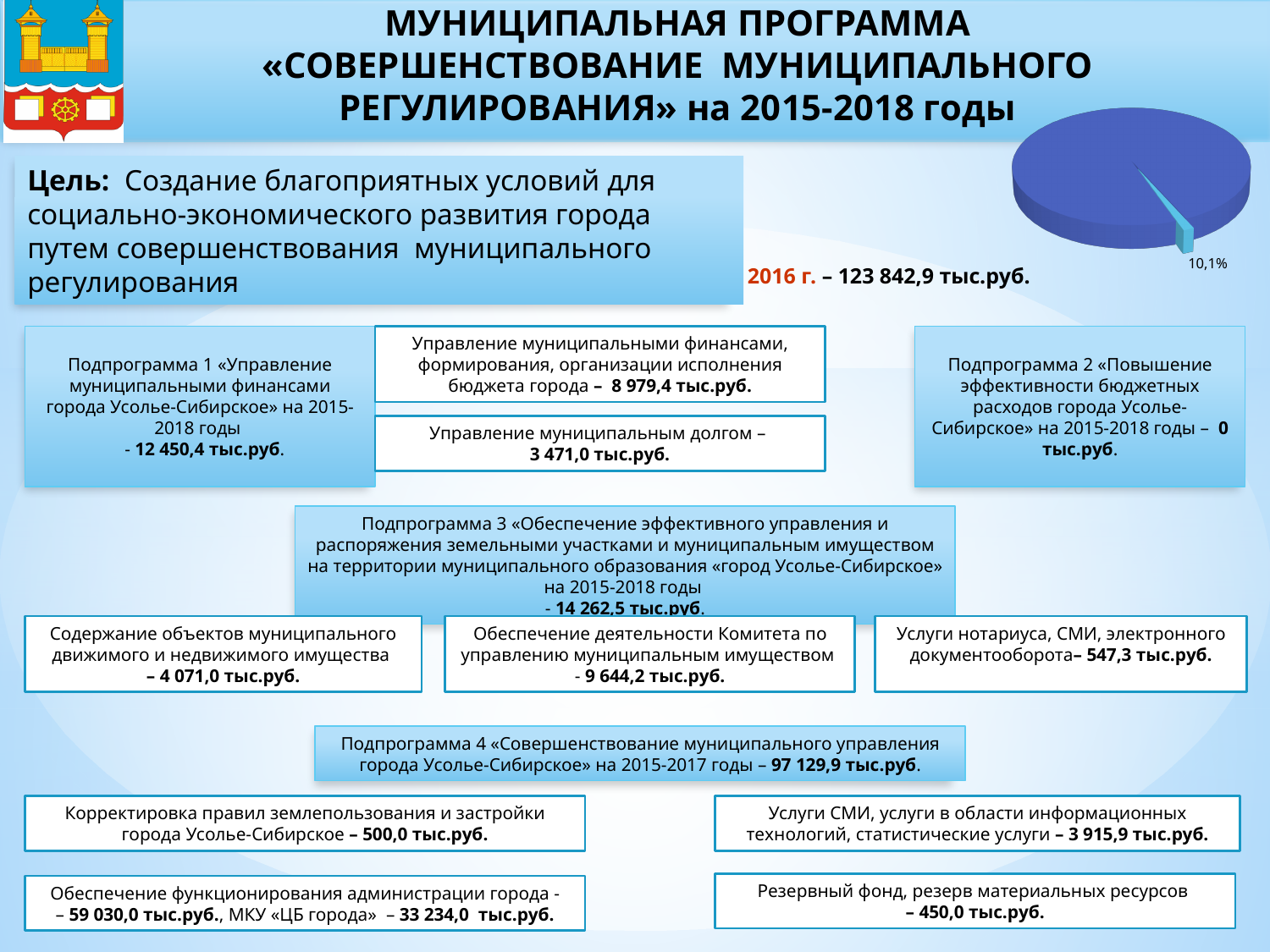
What colour is the small slice of the pie chart? light blue What percentage is printed on the small slice of the pie chart? 10,1% In the pie chart, which slice is larger: the slice labelled 10,1% or the unlabelled slice? the unlabelled slice How many slices does the pie chart have? 2 What kind of chart is shown in the top right of the slide? pie chart Does the slice labelled 10,1% make up more or less than half of the pie chart? less